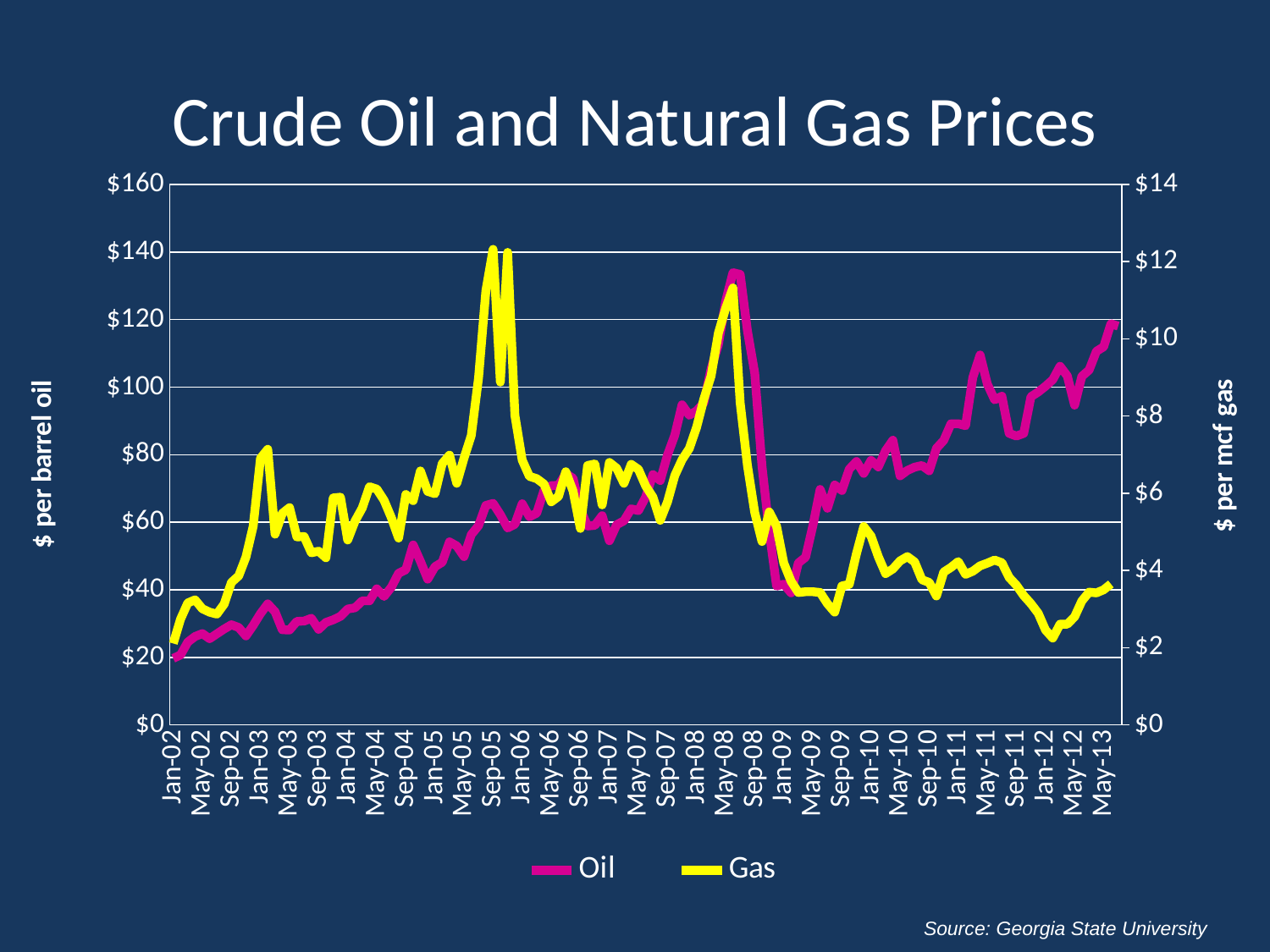
Is the Gas price in Jan-12 greater or less than $4 per mcf? less Is the highest Oil price reached in 2008 greater or less than $120 per barrel? greater What is the title of the chart? Crude Oil and Natural Gas Prices Which series is drawn in yellow? Gas Does the Oil price generally rise or fall from Jan-09 to May-13? rise Is the Oil price in Jan-05 greater or less than $60 per barrel? less What kind of chart is shown on the slide? Line chart How many series does the legend list? 2